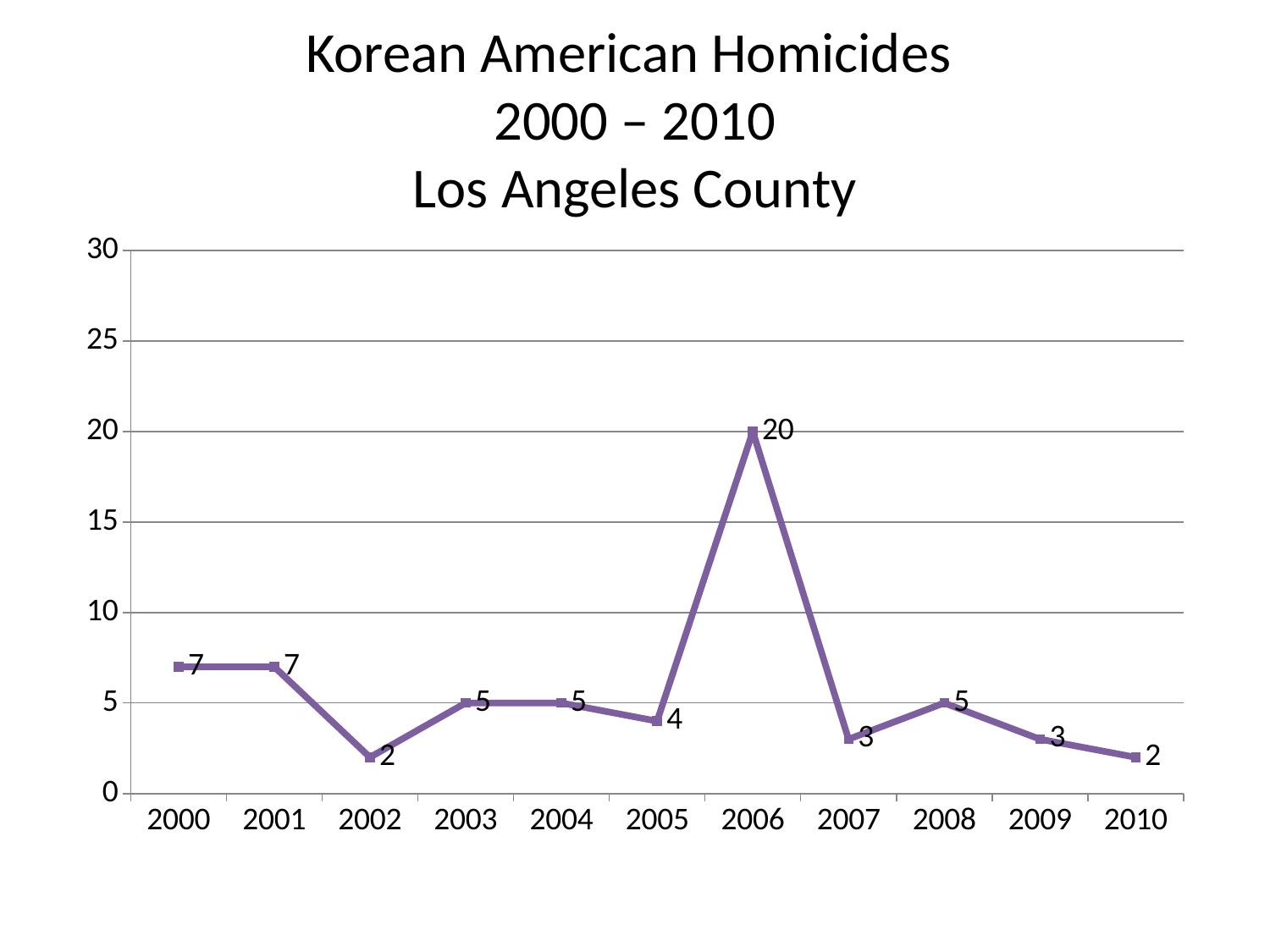
Do the values rise or fall from 2008 to 2010? fall How many years are plotted on the x axis? 11 What kind of chart is shown on the slide? line chart What is the title of the chart? Korean American Homicides 2000 – 2010 Los Angeles County What is the value for 2010? 2 Is the value for 2006 greater or less than 15? greater What is the difference between the values for 2006 and 2007? 17 What is the difference between the values for 2000 and 2002? 5 What is the value for 2005? 4 Which year has the highest value? 2006 Which is larger, the value for 2001 or the value for 2008? 2001 How many homicides were recorded in 2006? 20